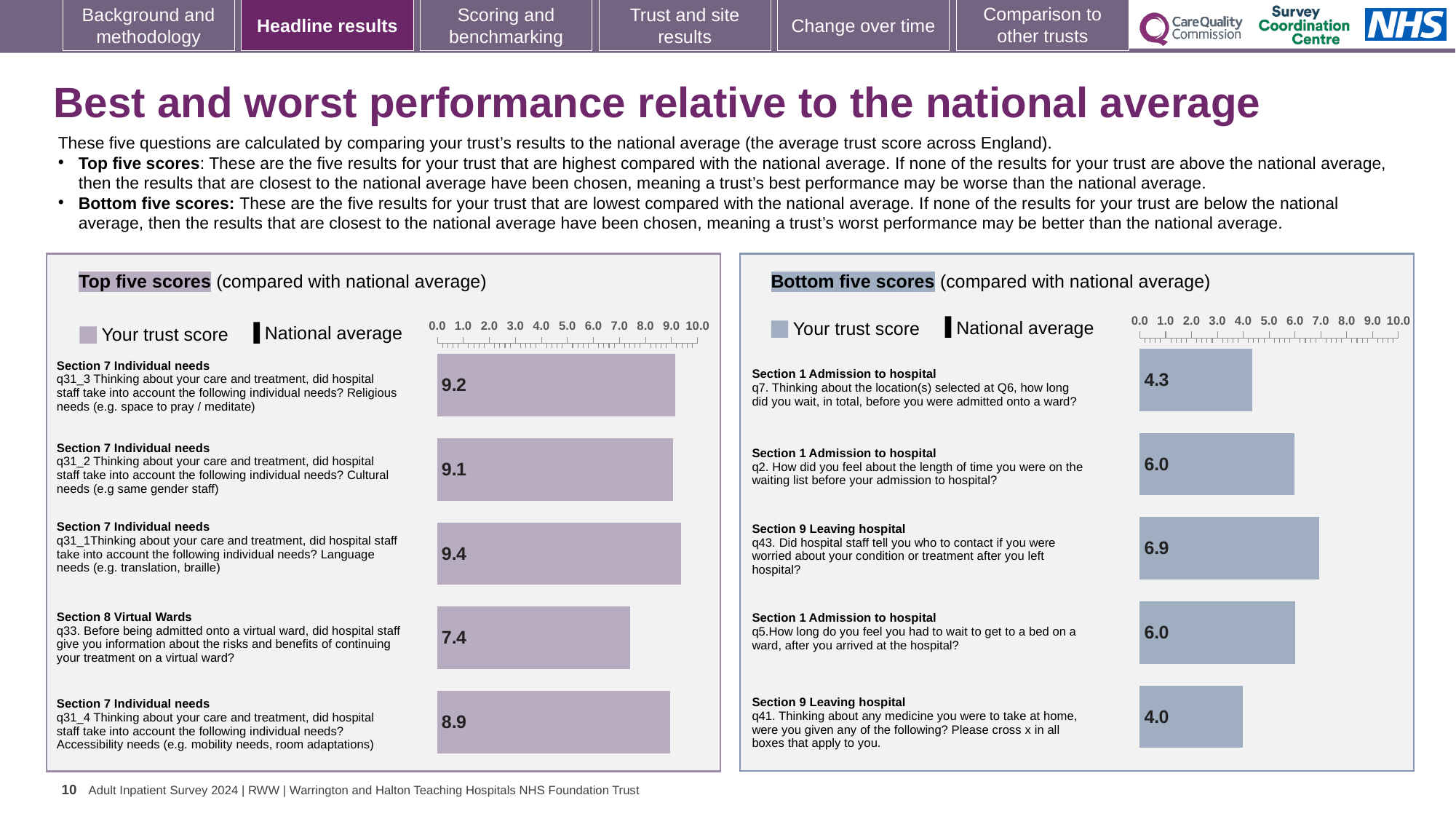
In the Top five scores chart, what is the trust score for q33 (virtual ward information about risks and benefits)? 7.4 In the Bottom five scores chart, which question has the highest trust score? q43 (who to contact after leaving hospital) In the Bottom five scores chart, what is the trust score for q43 (did staff tell you who to contact if worried after leaving hospital)? 6.9 In the Top five scores chart, what is the trust score for q31_1 (language needs)? 9.4 In the Bottom five scores chart, which question has the lowest trust score? q41 (medicine to take at home) In the Bottom five scores chart, what is the trust score for q7 (how long did you wait before being admitted onto a ward)? 4.3 In the Top five scores chart, which question has the lowest trust score? q33 (virtual ward risks and benefits) In the Top five scores chart, which question has the highest trust score? q31_1 (Language needs) In the Bottom five scores chart, which is larger: the score for q7 or the score for q41? q7 How many bars are shown in the Bottom five scores chart? 5 What type of chart is used in the Top five scores panel? Bar chart In the Top five scores chart, what is the difference between the scores for q31_1 and q33? 2.0